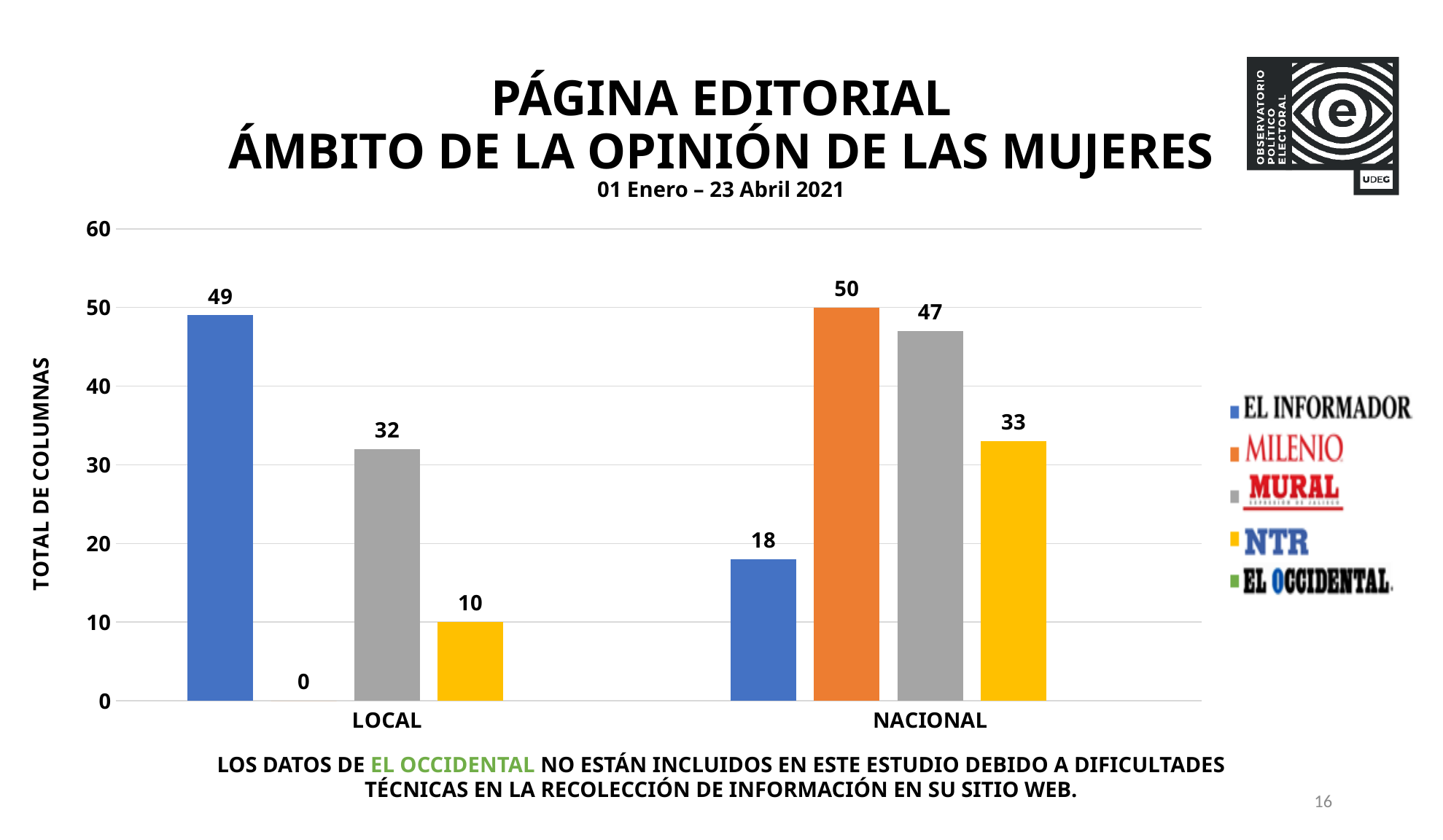
What is the label of the y axis? TOTAL DE COLUMNAS What is the value for MILENIO in the NACIONAL category? 50 What is the value for NTR in the LOCAL category? 10 What is the value for EL INFORMADOR in the LOCAL category? 49 What is the value for MURAL in the NACIONAL category? 47 Which newspaper has the lowest value in the NACIONAL category? EL INFORMADOR Which is larger: the MURAL value for LOCAL or the NTR value for NACIONAL? NTR value for NACIONAL How many categories are shown on the x axis? 2 What is the difference between the EL INFORMADOR values for LOCAL and NACIONAL? 31 Which newspaper has the highest value in the NACIONAL category? MILENIO What kind of chart is shown on the slide? Bar chart How many series does the legend list? 5